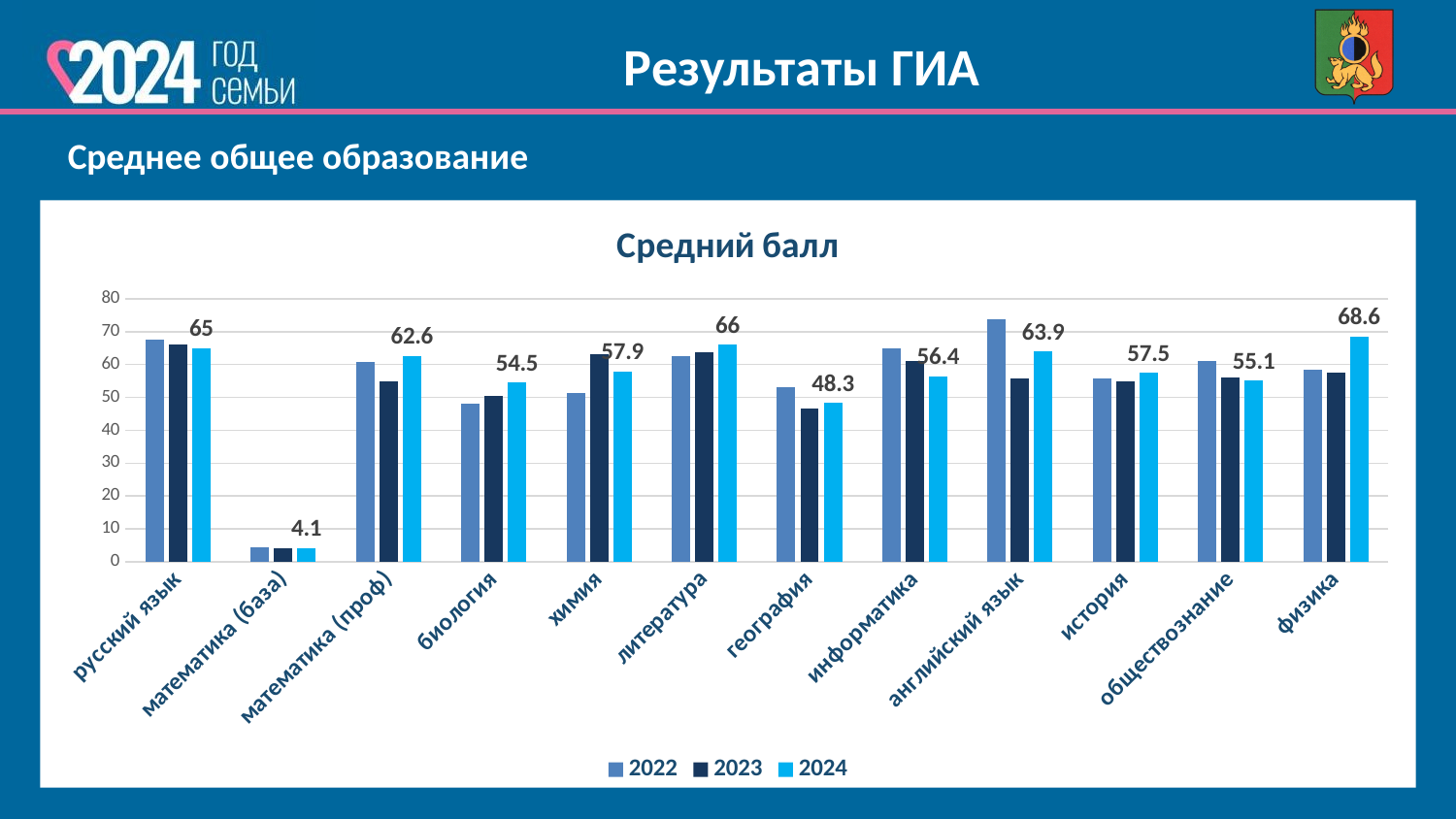
What is the 2024 value for литература? 66 Which has the larger 2024 value, биология or история? история What is the difference between the 2024 values for русский язык and география? 16.7 Which category has the lowest 2024 value? математика (база) What is the 2024 value for математика (база)? 4.1 How many categories are shown on the x axis? 12 What kind of chart is shown on the slide? bar chart How many series does the legend list? 3 Which category has the highest 2024 value? физика Is the 2022 value for английский язык greater or less than 70? greater What is the 2024 value for физика? 68.6 What is the 2024 value for география? 48.3